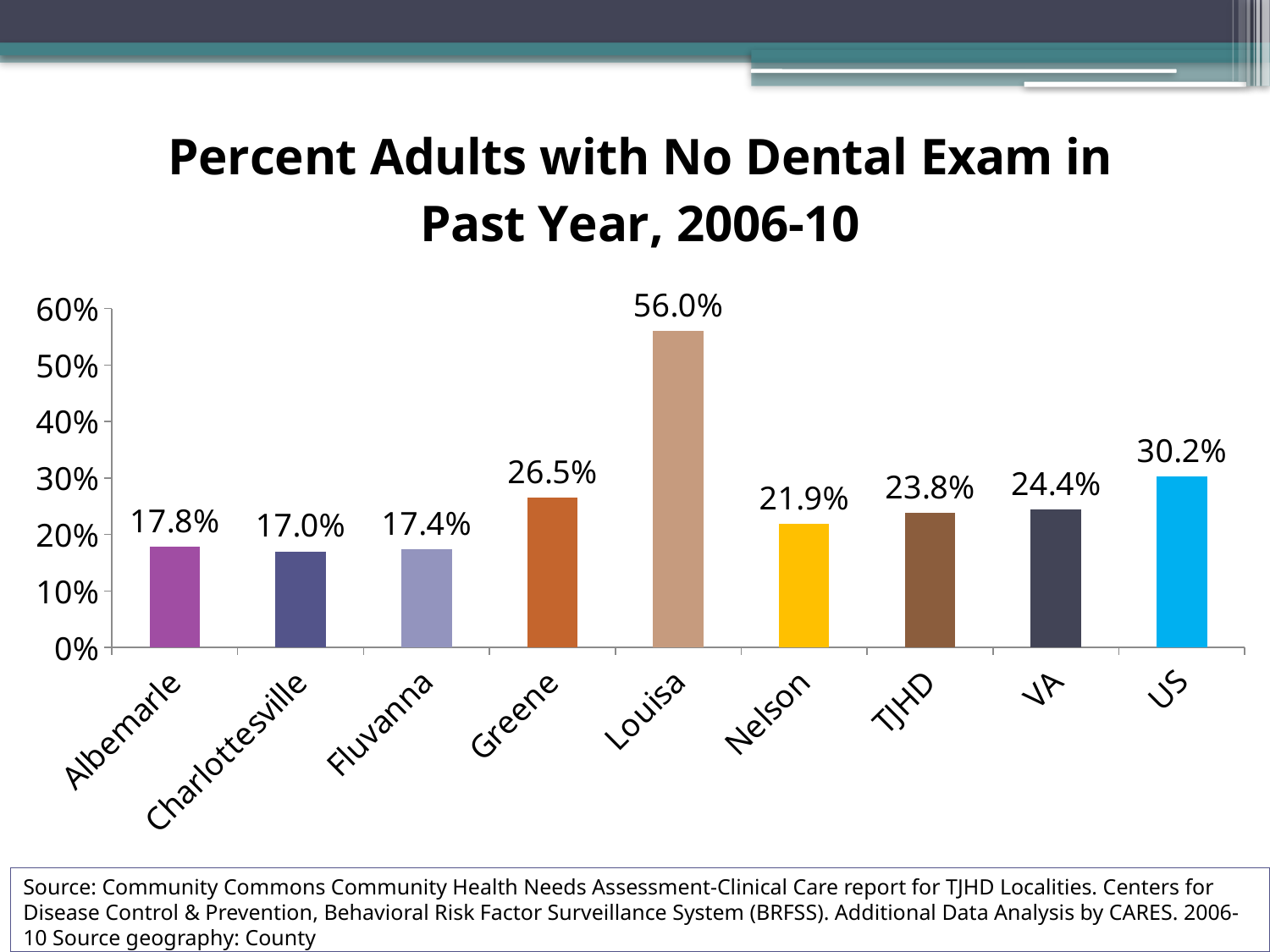
What is the difference between the values for Louisa and US? 25.8% What is the title of the chart? Percent Adults with No Dental Exam in Past Year, 2006-10 What is the value for Louisa? 56.0% How many categories are shown on the x axis? 9 Which is larger, the value for VA or the value for TJHD? VA What is the value for Charlottesville? 17.0% What is the value for US? 30.2% What is the difference between the values for Greene and Nelson? 4.6% What kind of chart is shown on the slide? bar chart Is the value for Louisa greater or less than 50%? greater Which category has the highest value? Louisa Which category has the lowest value? Charlottesville